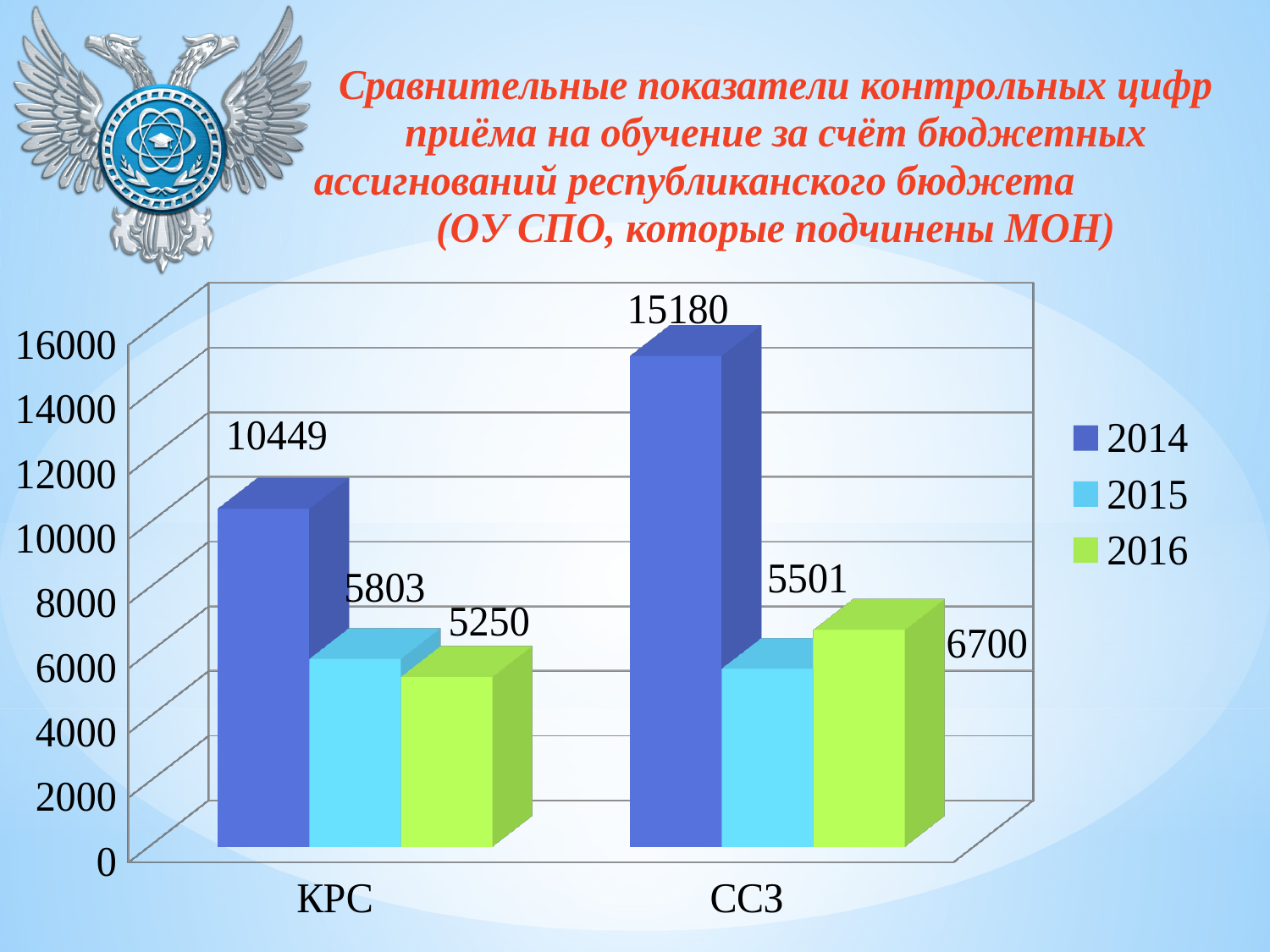
What is the value for КРС in 2014? 10449 Which colour represents the 2016 series in the legend? green How many series does the legend list? 3 How many categories are shown on the x axis? 2 What is the value for ССЗ in 2015? 5501 What is the value for КРС in 2015? 5803 What is the difference between the 2014 values for ССЗ and КРС? 4731 Which category has the highest value in 2014? ССЗ Which is larger: the 2015 value for КРС or the 2015 value for ССЗ? КРС What kind of chart is shown on the slide? bar chart Which category has the lowest value in 2016? КРС What is the value for ССЗ in 2016? 6700